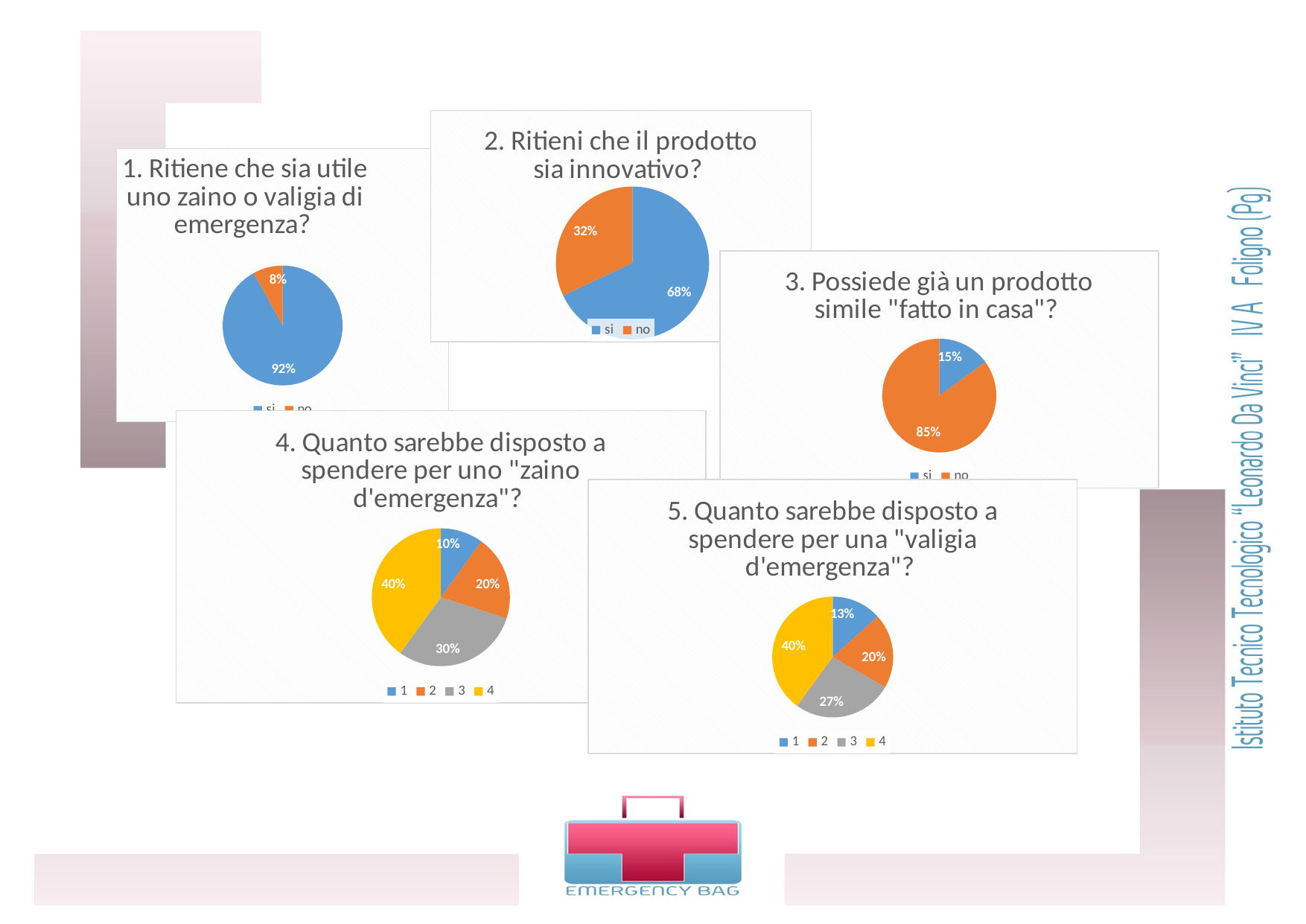
How many categories does the legend list in the chart titled "5. Quanto sarebbe disposto a spendere per una "valigia d'emergenza"?"? 4 In the chart titled "4. Quanto sarebbe disposto a spendere per uno "zaino d'emergenza"?", what is the value for category 3? 30% In the chart titled "1. Ritiene che sia utile uno zaino o valigia di emergenza?", what is the value for "no"? 8% In the chart titled "2. Ritieni che il prodotto sia innovativo?", what is the difference between the "si" and "no" shares? 36% In the chart titled "5. Quanto sarebbe disposto a spendere per una "valigia d'emergenza"?", what is the value for category 1? 13% In the chart titled "4. Quanto sarebbe disposto a spendere per uno "zaino d'emergenza"?", which category has the smallest share? 1 In the chart titled "3. Possiede già un prodotto simile "fatto in casa"?", what is the value for "si"? 15% What type of chart is used for "2. Ritieni che il prodotto sia innovativo?"? Pie chart In the chart titled "5. Quanto sarebbe disposto a spendere per una "valigia d'emergenza"?", which is larger, category 3 or category 2? 3 In the chart titled "3. Possiede già un prodotto simile "fatto in casa"?", which category is largest? no In the chart titled "1. Ritiene che sia utile uno zaino o valigia di emergenza?", what share of the pie is "si"? 92% In the chart titled "2. Ritieni che il prodotto sia innovativo?", what is the value for "no"? 32%